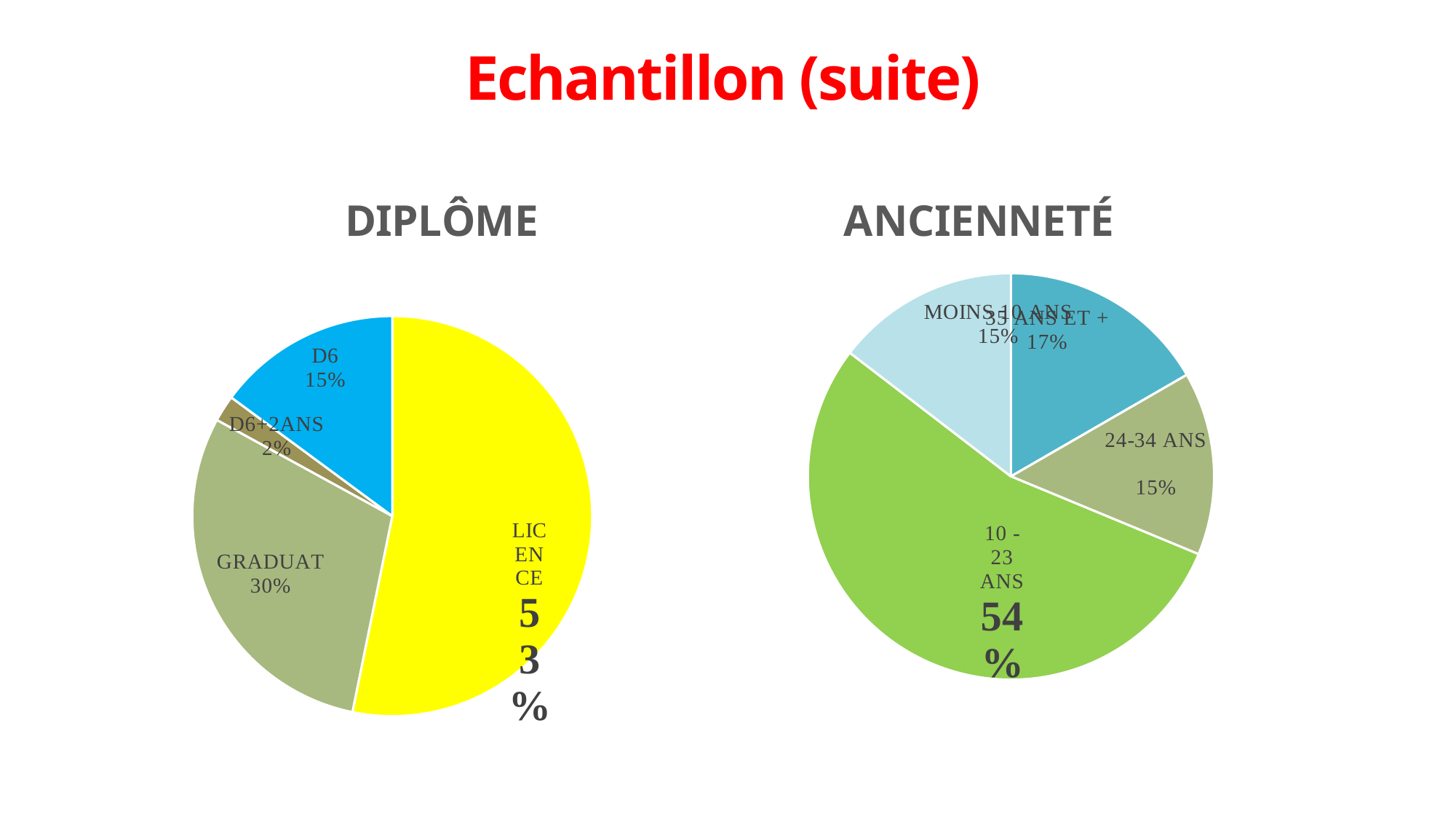
In the ANCIENNETÉ chart, which category has the largest share? 10 - 23 ANS In the DIPLÔME chart, what is the difference between the shares of GRADUAT and D6? 15% In the DIPLÔME chart, which category has the largest share? LICENCE In the ANCIENNETÉ chart, what is the difference between the shares of 10 - 23 ANS and 24-34 ANS? 39% What type of chart is the ANCIENNETÉ chart? Pie chart In the DIPLÔME chart, what share does D6+2ANS have? 2% In the DIPLÔME chart, which category has the smallest share? D6+2ANS In the DIPLÔME chart, what share does GRADUAT have? 30% How many slices does the DIPLÔME pie chart have? 4 In the ANCIENNETÉ chart, what share does 10 - 23 ANS have? 54% In the ANCIENNETÉ chart, what share does 35 ANS ET + have? 17% In the DIPLÔME chart, what share does LICENCE have? 53%